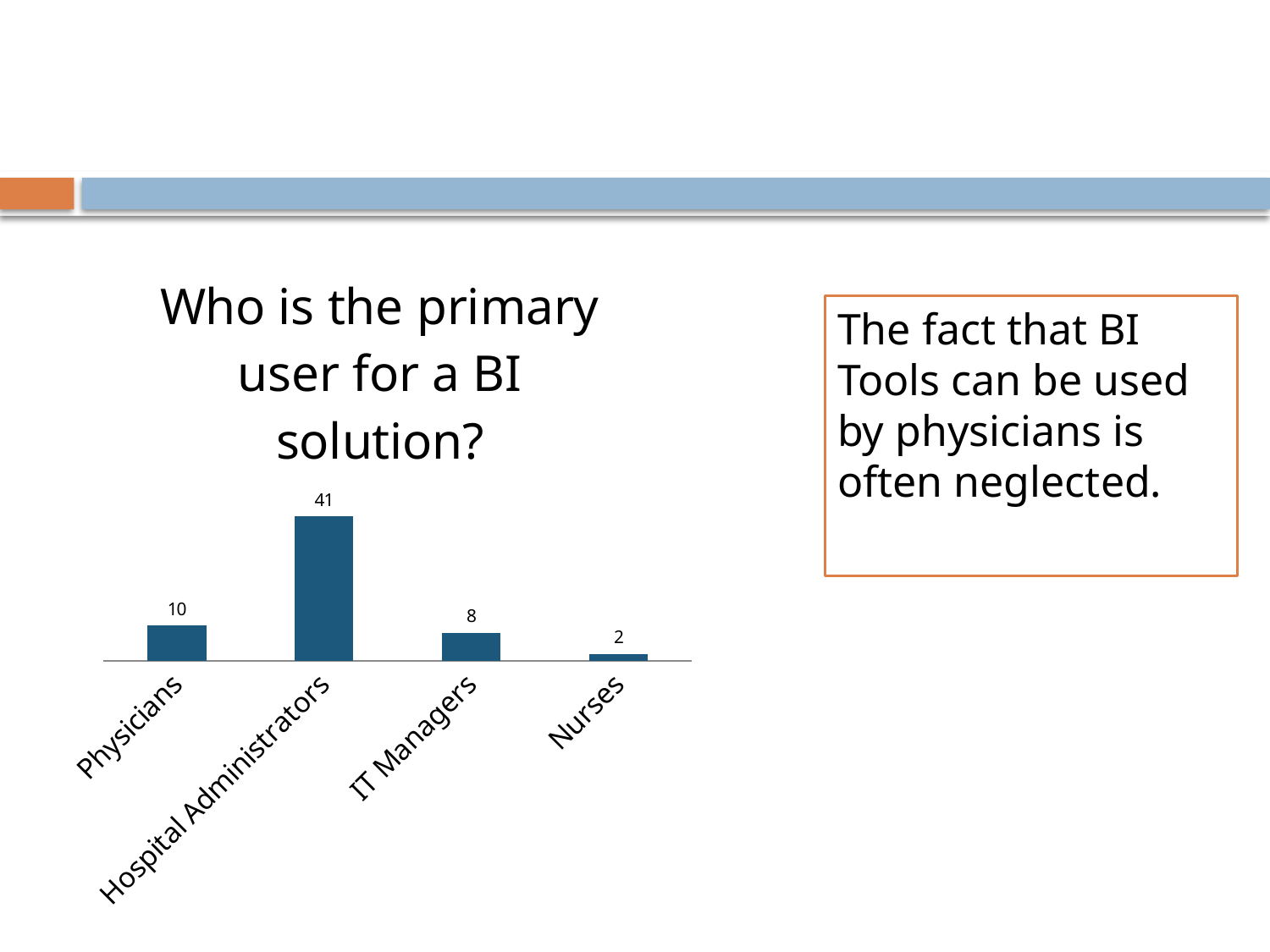
Which category has the highest value? Hospital Administrators Which category has the lowest value? Nurses What is the difference between the values for Hospital Administrators and Physicians? 31 What kind of chart is shown on the slide? Bar chart What is the value for Physicians? 10 How many categories are shown in the chart? 4 What is the value for Hospital Administrators? 41 What is the title of the chart? Who is the primary user for a BI solution? What is the value for Nurses? 2 What is the difference between the values for IT Managers and Nurses? 6 Which is larger, the value for Physicians or the value for IT Managers? Physicians What is the value for IT Managers? 8